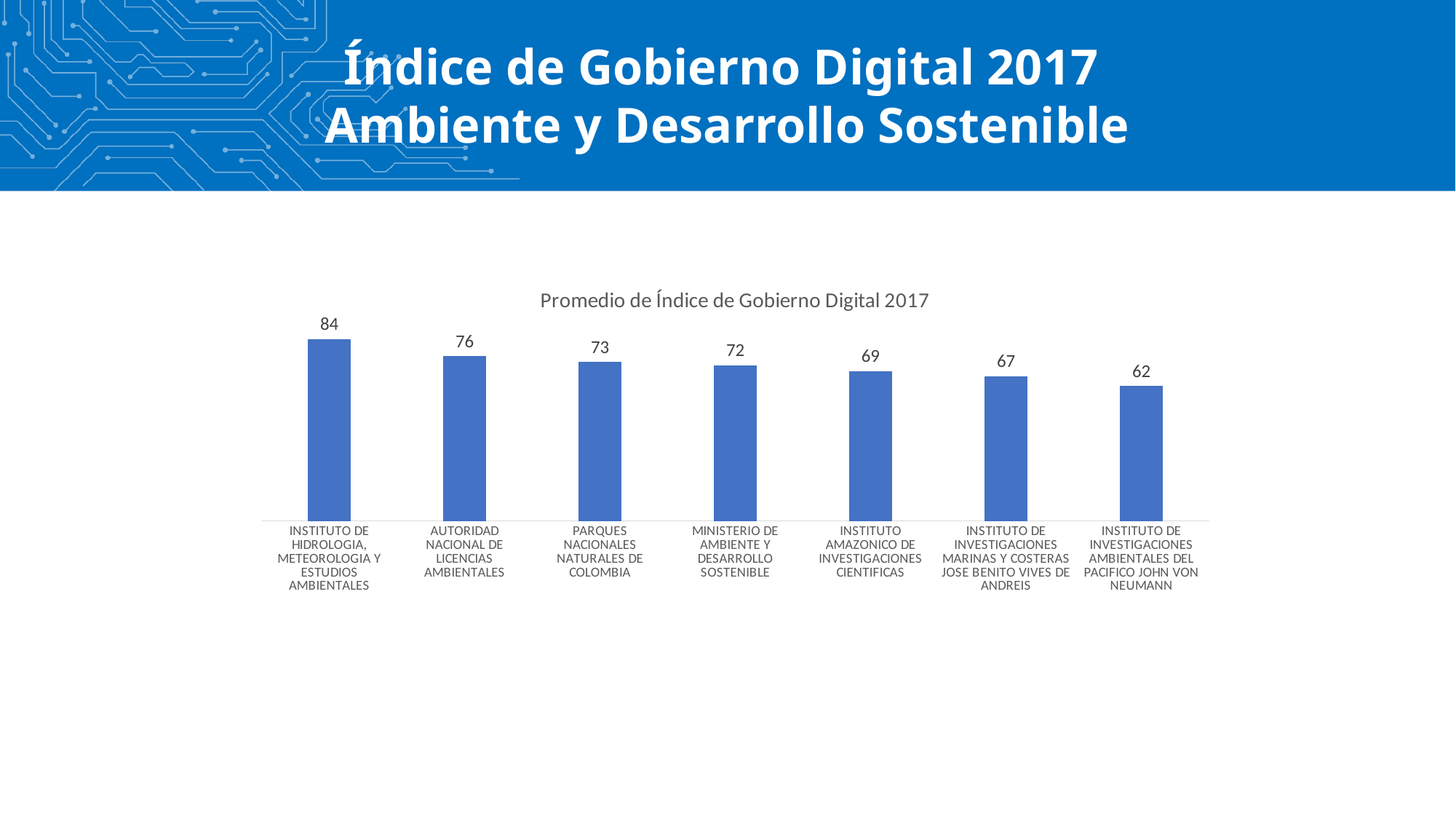
Which entity has the highest Promedio de Índice de Gobierno Digital 2017? Instituto de Hidrologia, Meteorologia y Estudios Ambientales Which entity has the lowest value on the chart? Instituto de Investigaciones Ambientales del Pacifico John Von Neumann What is the value for Parques Nacionales Naturales de Colombia? 73 What is the value for Ministerio de Ambiente y Desarrollo Sostenible? 72 What kind of chart is shown on the slide? Bar chart What is the difference between the values for Instituto de Hidrologia, Meteorologia y Estudios Ambientales and Instituto de Investigaciones Ambientales del Pacifico John Von Neumann? 22 How many entities are shown on the chart? 7 What is the value for Autoridad Nacional de Licencias Ambientales? 76 What is the title of the chart? Promedio de Índice de Gobierno Digital 2017 Which has a higher value, Autoridad Nacional de Licencias Ambientales or Instituto Amazonico de Investigaciones Cientificas? Autoridad Nacional de Licencias Ambientales What is the difference between the values for Instituto Amazonico de Investigaciones Cientificas and Instituto de Investigaciones Marinas y Costeras Jose Benito Vives de Andreis? 2 Do the values rise or fall from left to right across the chart? Fall